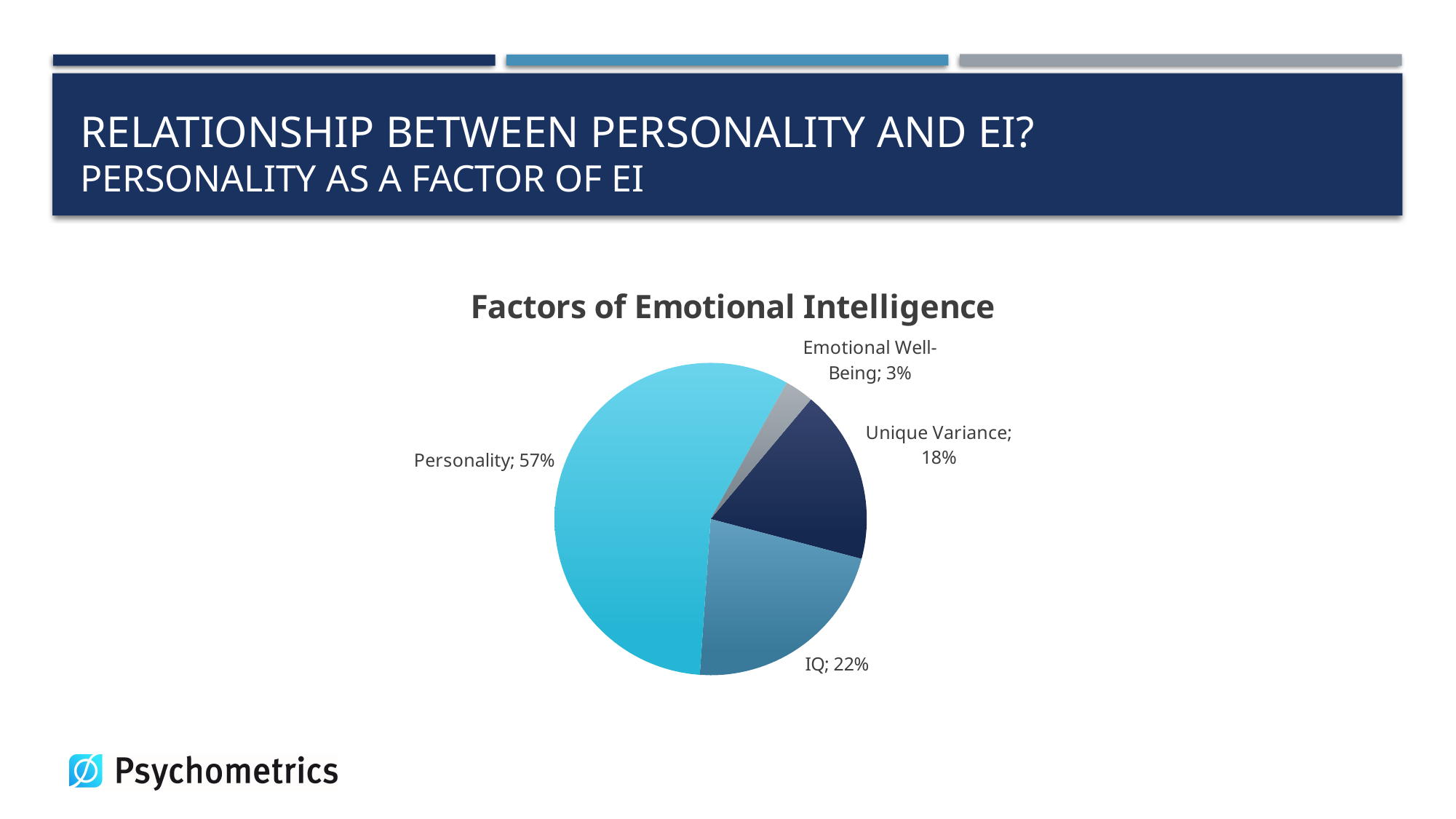
What percentage of the pie is attributed to Personality? 57% What type of chart is shown on the slide? pie chart Which factor has the smallest slice of the pie? Emotional Well-Being What percentage of the pie is attributed to Unique Variance? 18% What is the difference in percentage points between Unique Variance and Emotional Well-Being? 15 What is the difference in percentage points between Personality and IQ? 35 Which is larger, the IQ slice or the Unique Variance slice? IQ What is the title of the chart? Factors of Emotional Intelligence What percentage of the pie is attributed to Emotional Well-Being? 3% How many slices does the pie chart have? 4 What percentage of the pie is attributed to IQ? 22% Which factor has the largest slice of the pie? Personality